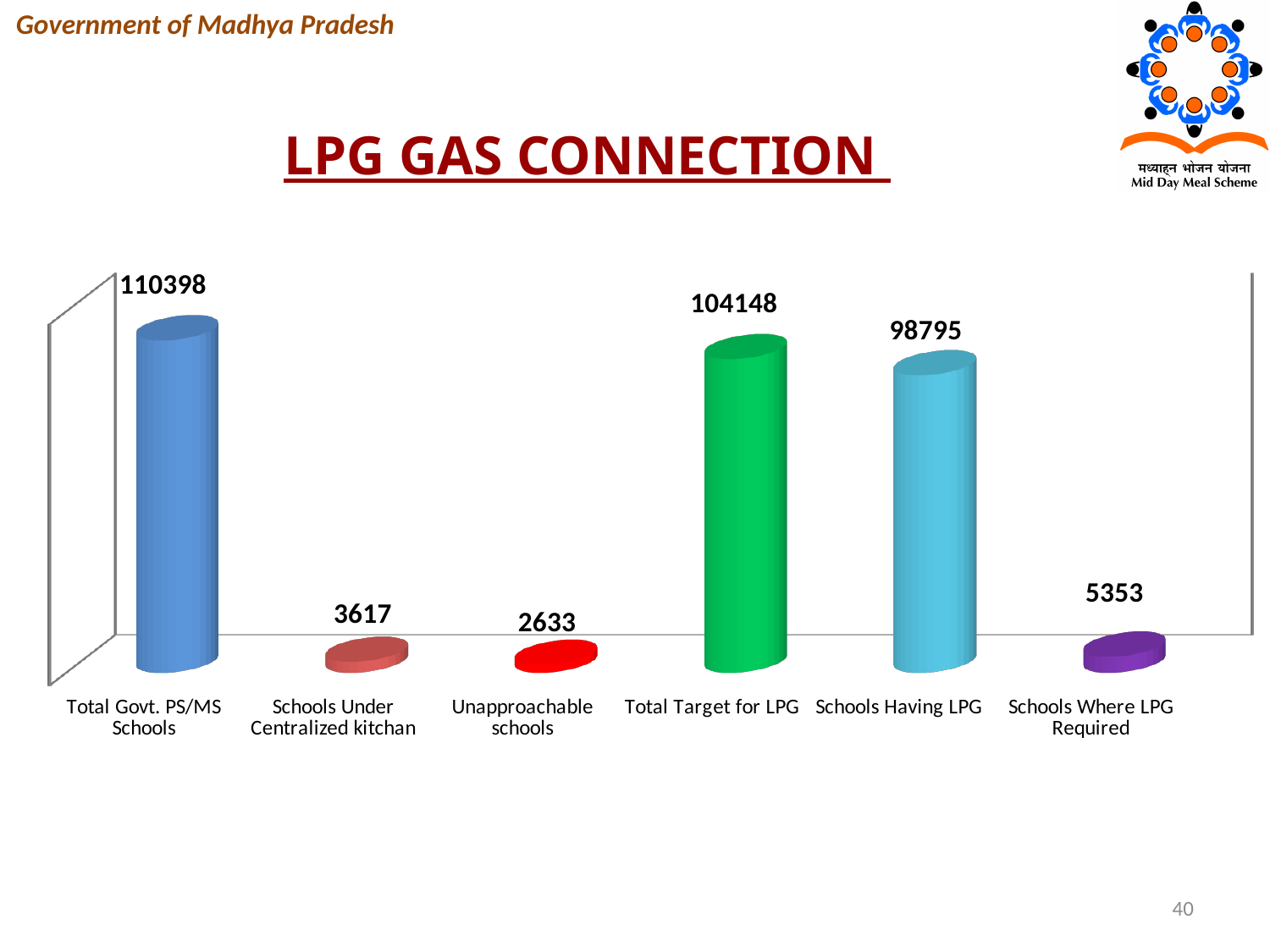
What is the value for Unapproachable schools? 2633 What is the value for Schools Having LPG? 98795 Which is larger, Schools Under Centralized kitchan or Schools Where LPG Required? Schools Where LPG Required Which category has the lowest value? Unapproachable schools How many categories are shown in the chart? 6 What is the value for Schools Where LPG Required? 5353 What is the difference between Total Target for LPG and Schools Having LPG? 5353 What type of chart is shown on the slide? Bar chart Which category has the highest value? Total Govt. PS/MS Schools What is the value for Total Govt. PS/MS Schools? 110398 What is the value for Total Target for LPG? 104148 What is the value for Schools Under Centralized kitchan? 3617